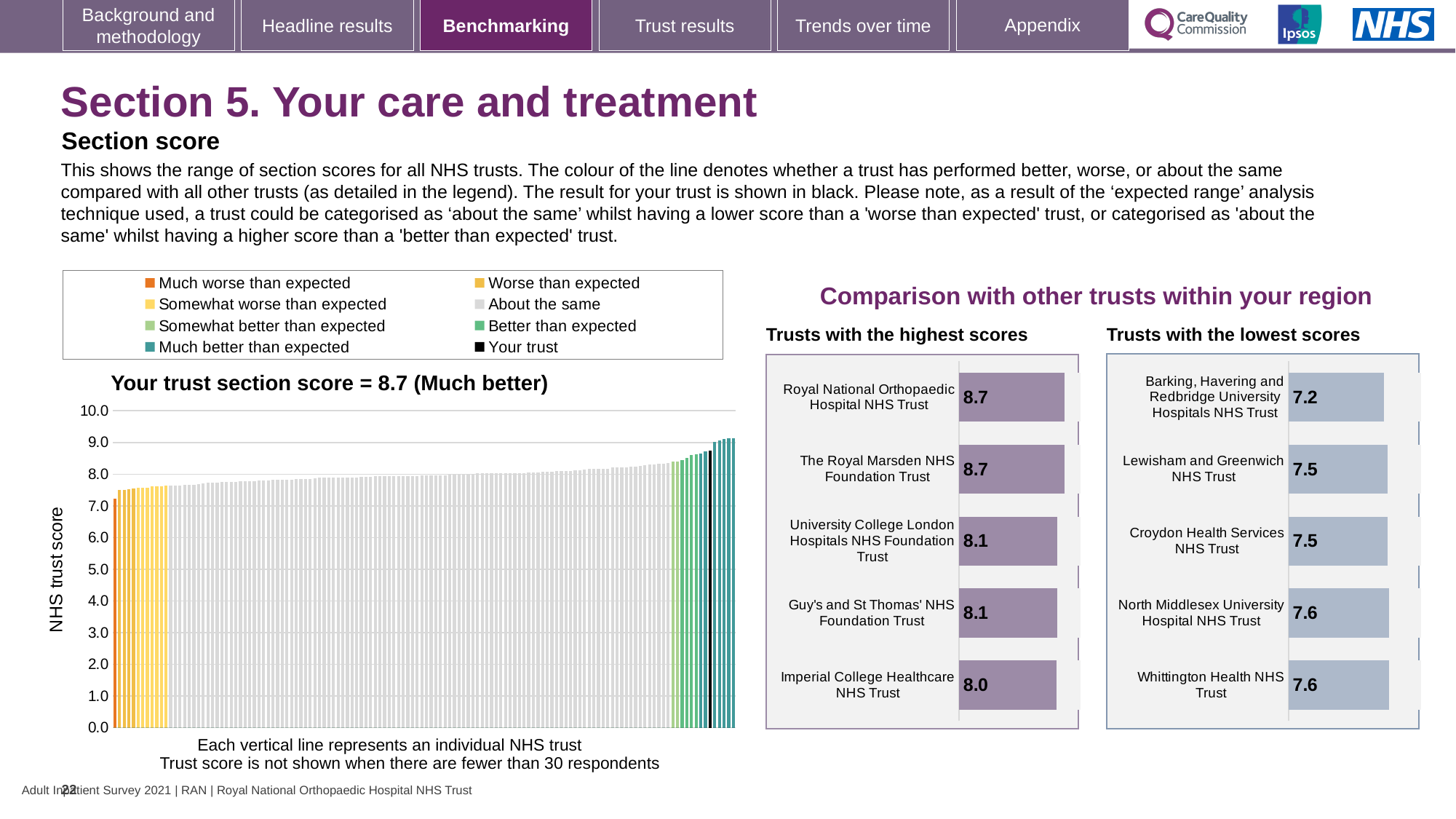
On the 'Your trust section score' chart, is the value of the leftmost (lowest) bar greater or less than 8.0? less On the 'Trusts with the lowest scores' chart, which trust has the lowest score? Barking, Havering and Redbridge University Hospitals NHS Trust On the 'Your trust section score' chart, do the trust scores rise or fall from left to right? rise On the 'Trusts with the lowest scores' chart, what is the score for Whittington Health NHS Trust? 7.6 On the 'Your trust section score' chart, what is the section score for your trust? 8.7 On the 'Trusts with the highest scores' chart, what is the score for Imperial College Healthcare NHS Trust? 8.0 On the 'Trusts with the highest scores' chart, what is the difference between the scores of Royal National Orthopaedic Hospital NHS Trust and Imperial College Healthcare NHS Trust? 0.7 What kind of chart is the 'Your trust section score' chart? bar chart On the 'Trusts with the lowest scores' chart, what is the difference between the scores of Whittington Health NHS Trust and Barking, Havering and Redbridge University Hospitals NHS Trust? 0.4 On the 'Your trust section score' chart, what colour is used to show your trust? black On the 'Your trust section score' chart, how many entries does the legend list? 8 On the 'Trusts with the highest scores' chart, how many trusts are shown? 5